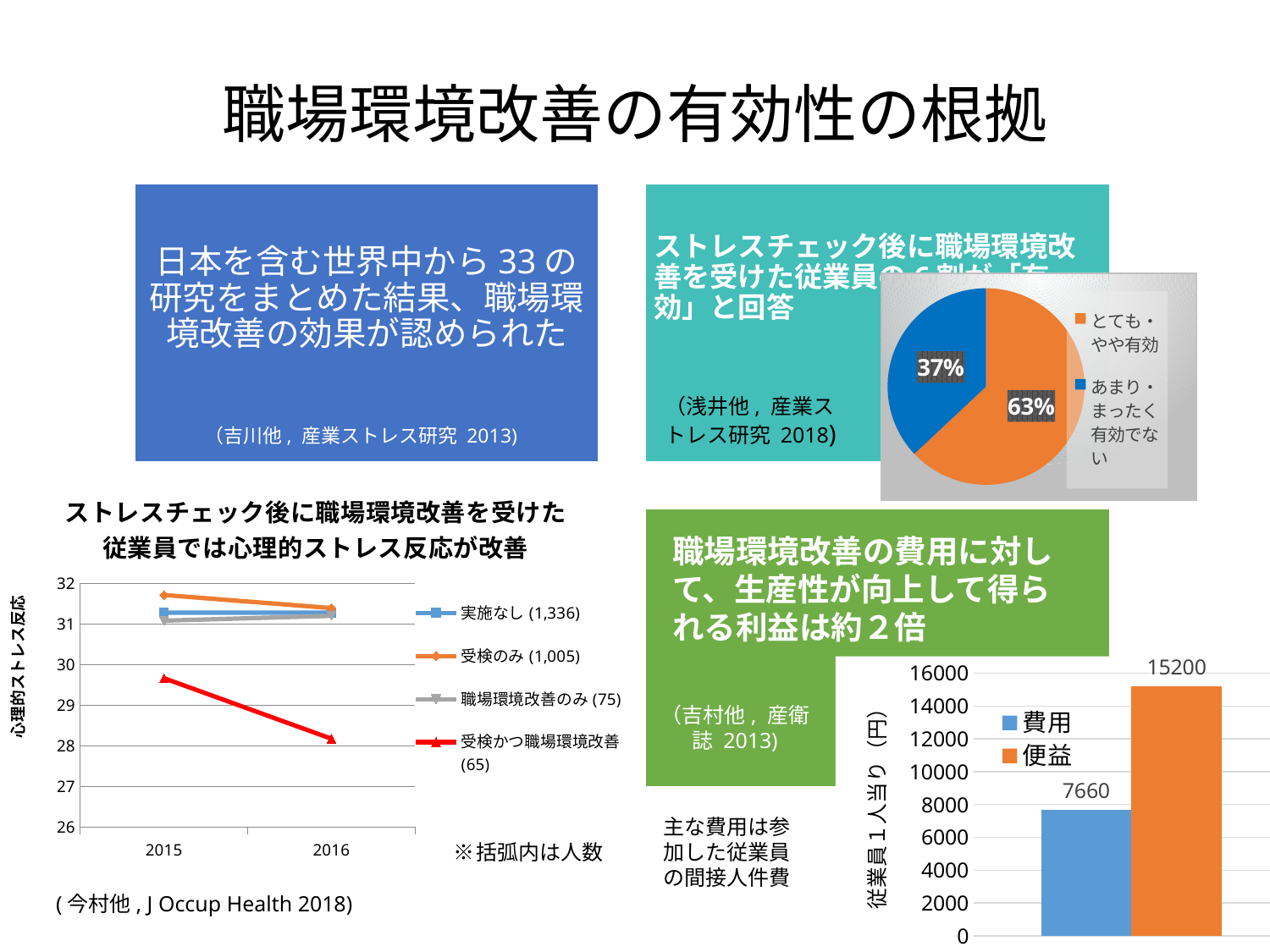
In the bar chart at the bottom right, what is the difference between 便益 and 費用? 7540 In the line chart at the bottom left, is the 2015 value for 受検かつ職場環境改善 (65) greater or less than 30? less What kind of chart is shown at the bottom right of the slide? bar chart In the pie chart at the top right, how many percentage points larger is the とても・やや有効 slice than the あまり・まったく有効でない slice? 26 In the pie chart at the top right, what share of respondents answered とても・やや有効? 63% In the pie chart at the top right, which slice is larger, とても・やや有効 or あまり・まったく有効でない? とても・やや有効 In the pie chart at the top right, what share of respondents answered あまり・まったく有効でない? 37% In the bar chart at the bottom right, what is the value for 便益? 15200 In the bar chart at the bottom right, what is the value for 費用? 7660 In the line chart at the bottom left, does the value for 受検かつ職場環境改善 (65) rise or fall from 2015 to 2016? fall In the bar chart at the bottom right, which is higher, 費用 or 便益? 便益 In the line chart at the bottom left, how many series does the legend list? 4